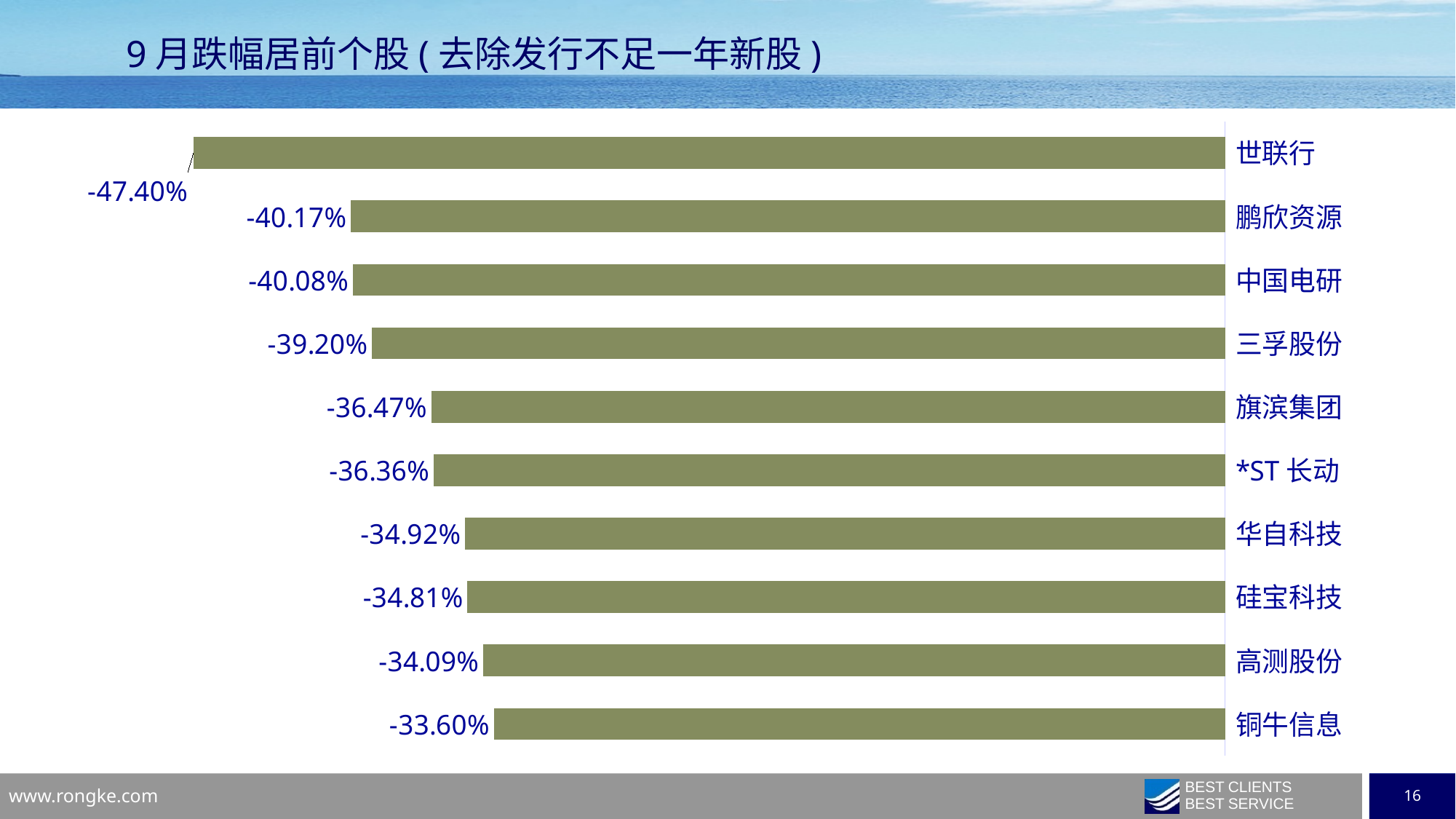
What is the title of the chart on the slide? 9月跌幅居前个股(去除发行不足一年新股) Which stock has the smallest decline (the highest value) in the chart? 铜牛信息 Which stock has the largest decline (the lowest value) in the chart? 世联行 What is the value shown for 旗滨集团? -36.47% What is the difference in percentage points between the values for 鹏欣资源 and 中国电研? 0.09 percentage points How many stocks are shown in the chart? 10 Which stock fell more in September, 三孚股份 or 华自科技? 三孚股份 What is the value shown for 世联行? -47.40% What is the value shown for 铜牛信息? -33.60% What is the difference in percentage points between the values for 世联行 and 铜牛信息? 13.80 percentage points What is the value shown for *ST长动? -36.36% What kind of chart is shown on the slide? bar chart